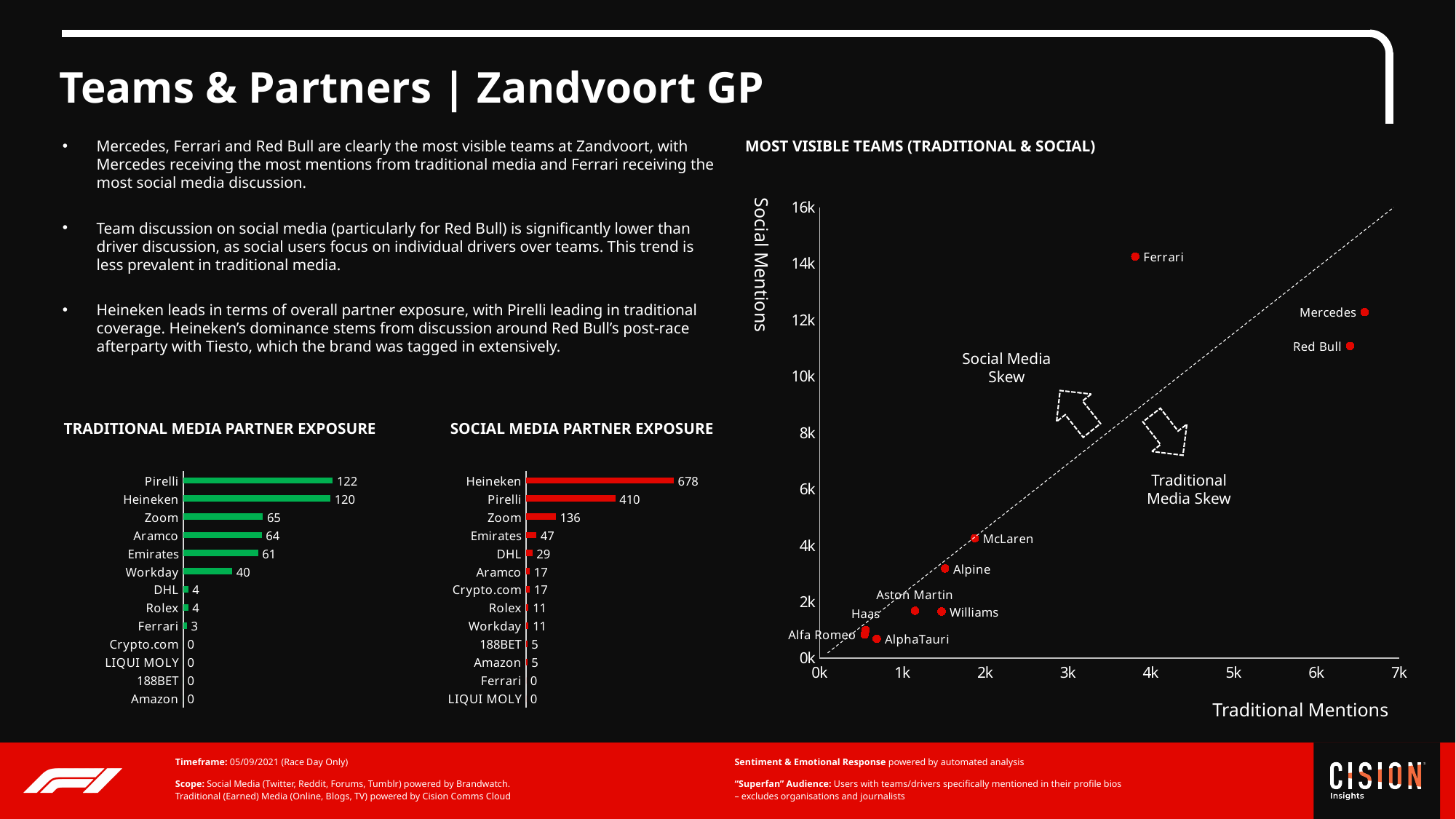
In the Traditional Media Partner Exposure chart, what is the difference between Zoom and Workday? 25 In the Most Visible Teams chart, is the traditional mentions value for Mercedes greater or less than 6k? greater In the Most Visible Teams chart, how many teams are plotted? 10 What kind of chart is the Social Media Partner Exposure chart? Bar chart In the Social Media Partner Exposure chart, what is the difference between Heineken and Pirelli? 268 In the Traditional Media Partner Exposure chart, how many partners are listed? 13 In the Social Media Partner Exposure chart, which is larger, the value for Zoom or the value for Emirates? Zoom In the Traditional Media Partner Exposure chart, which partner has the highest value? Pirelli In the Most Visible Teams chart, is the social mentions value for Ferrari greater or less than 12k? greater In the Social Media Partner Exposure chart, what is the value for Heineken? 678 In the Traditional Media Partner Exposure chart, what is the value for Pirelli? 122 In the Social Media Partner Exposure chart, which partner has the highest value? Heineken